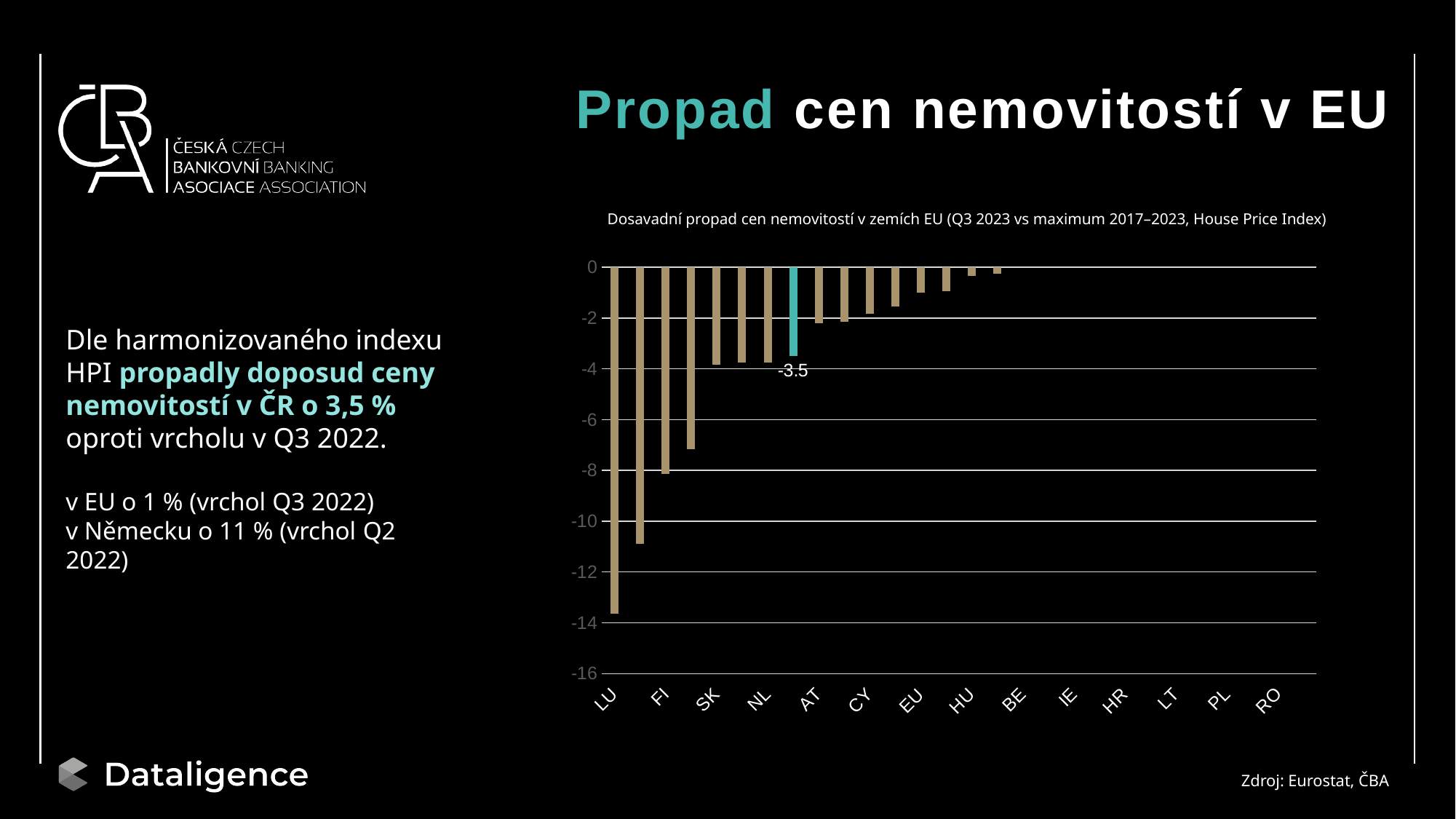
Is the value of the rightmost bar in the chart greater or less than -2? greater What kind of chart is shown on the slide? bar chart Is the value of the second bar from the left greater or less than -10? less Is the value of the leftmost bar in the chart greater or less than -12? less Do the bar values rise or fall (become less negative) moving from left to right along the x axis? rise What is the title of the chart? Dosavadní propad cen nemovitostí v zemích EU (Q3 2023 vs maximum 2017–2023, House Price Index) What value is printed as a data label on the highlighted (teal) bar in the chart? -3.5 Which category label appears first (leftmost) on the x axis of the chart? LU